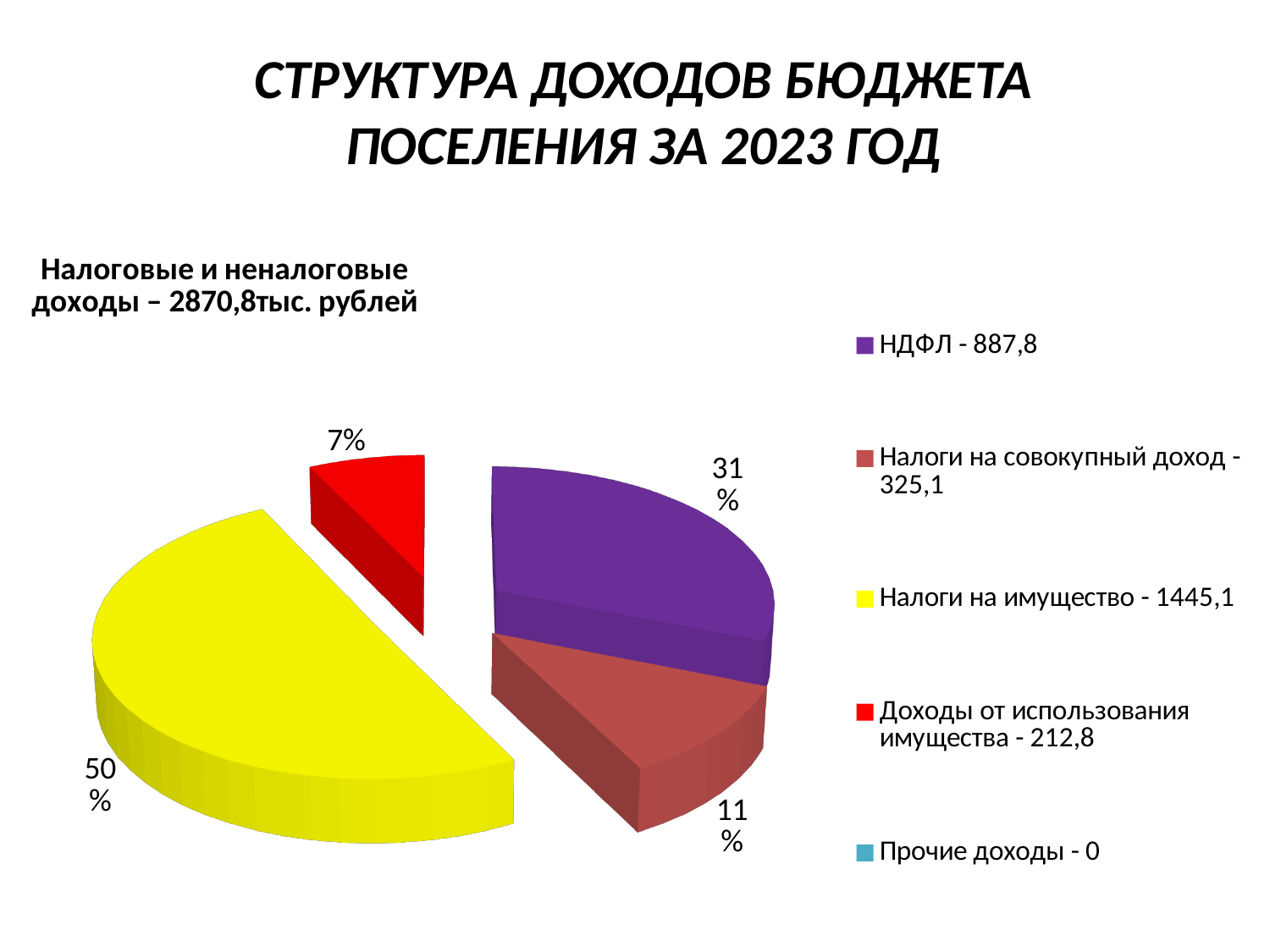
What colour is the slice for Налоги на имущество? yellow Which category has the largest slice of the pie? Налоги на имущество What share of the pie does the slice for Налоги на совокупный доход take? 11% Which category with a visible slice has the smallest share of the pie? Доходы от использования имущества What share of the pie does the slice for Доходы от использования имущества take? 7% What share of the pie does the slice for Налоги на имущество take? 50% What kind of chart is shown on the slide? pie chart How many entries does the legend list? 5 Which slice is larger: НДФЛ or Доходы от использования имущества? НДФЛ What is the difference in percentage points between the НДФЛ slice and the Налоги на совокупный доход slice? 20 What value does the legend give for Налоги на имущество? 1445,1